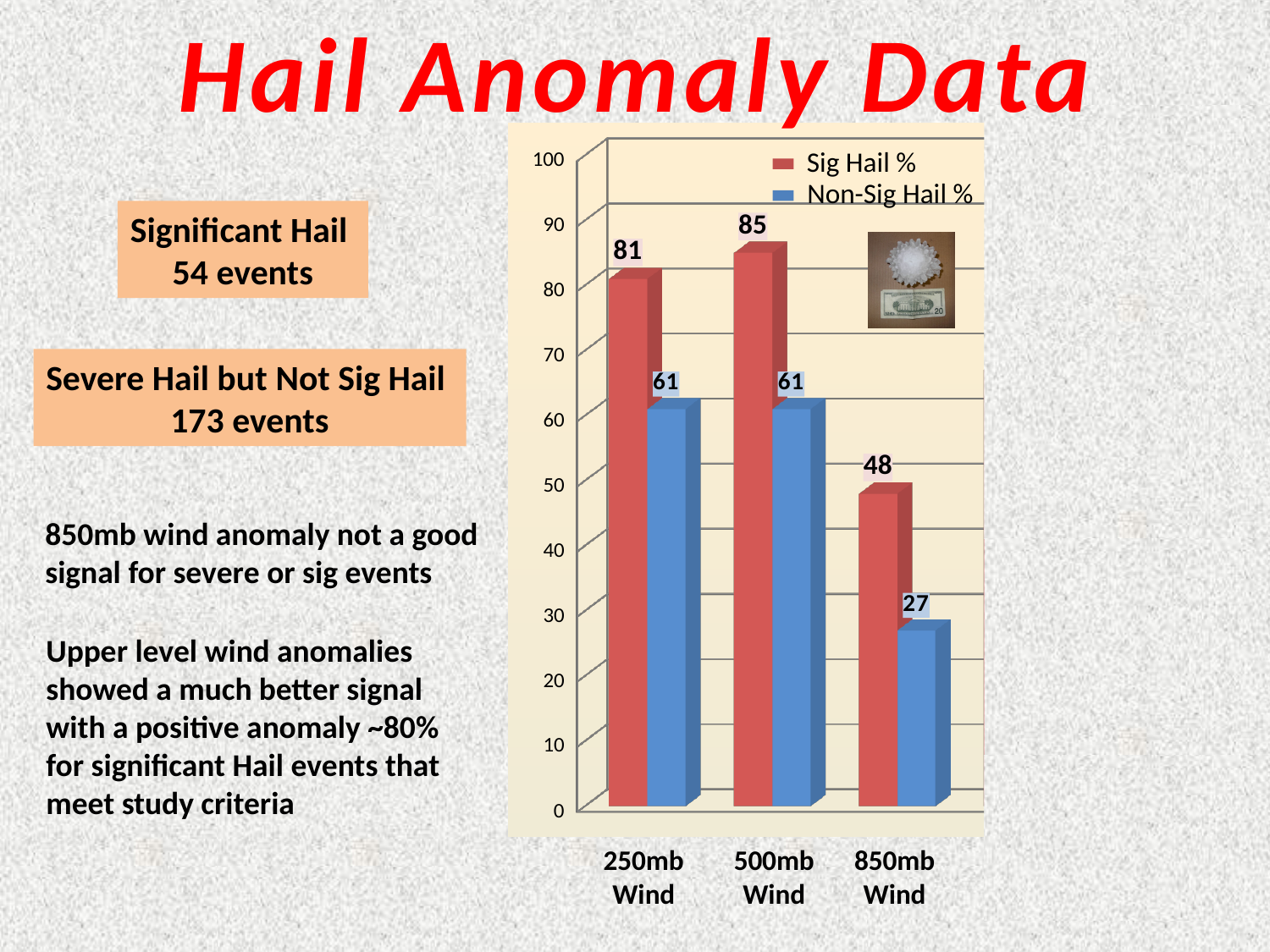
How many categories are shown on the x axis? 3 Which category has the highest Sig Hail % value? 500mb Wind What is the Sig Hail % value for 250mb Wind? 81 What kind of chart is shown on the slide? Bar chart What is the Sig Hail % value for 500mb Wind? 85 Which is larger for 250mb Wind: the Sig Hail % value or the Non-Sig Hail % value? Sig Hail % What colour are the Sig Hail % bars? Red What is the Non-Sig Hail % value for 850mb Wind? 27 What is the difference between the Sig Hail % and Non-Sig Hail % values for 850mb Wind? 21 How many series does the legend list? 2 Do the Non-Sig Hail % values rise or fall from 500mb Wind to 850mb Wind? Fall Which category has the lowest Non-Sig Hail % value? 850mb Wind